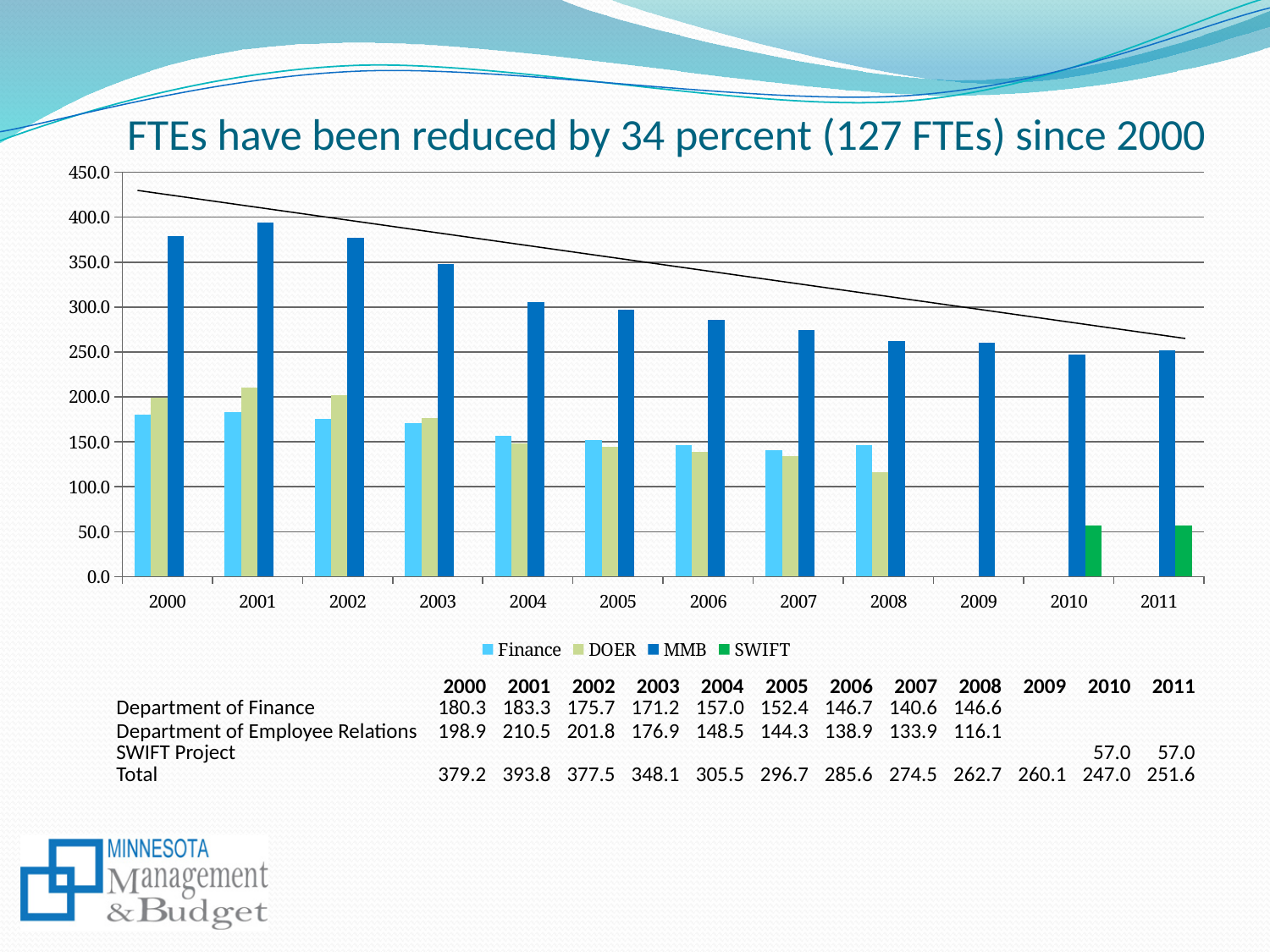
Does the MMB series generally rise or fall from 2000 to 2011? fall What is the value for DOER in 2001? 210.5 Which is larger, the Finance value in 2000 or the DOER value in 2000? DOER What kind of chart is shown on the slide? bar chart In which year is the MMB series lowest? 2010 In which year is the MMB series highest? 2001 What is the value for MMB in 2011? 251.6 How many series does the legend list? 4 How many years are shown on the x axis? 12 What is the value for SWIFT in 2010? 57.0 What is the value for Finance in 2000? 180.3 What is the difference between the MMB values for 2000 and 2011? 127.6